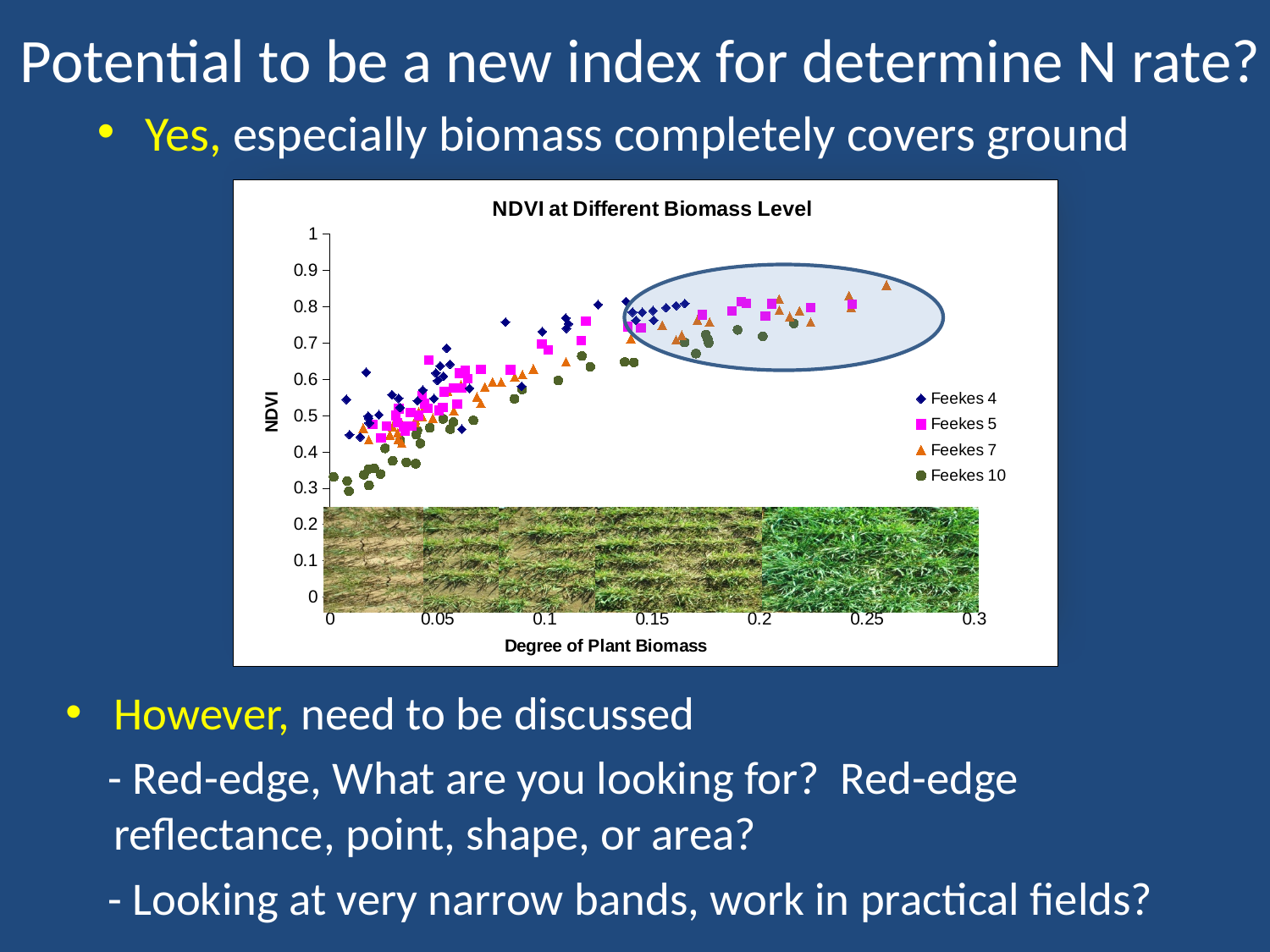
What is the label of the horizontal axis? Degree of Plant Biomass What is the label of the vertical axis? NDVI What kind of chart is shown on the slide? Scatter chart Which series reaches the highest NDVI value on the chart? Feekes 7 Does NDVI generally rise or fall as Degree of Plant Biomass increases? Rise Are the NDVI values of the Feekes 10 points at the lowest biomass levels (near 0) greater or less than 0.4? less What is the title of the chart? NDVI at Different Biomass Level Which series are listed in the chart's legend? Feekes 4, Feekes 5, Feekes 7, Feekes 10 What is the maximum value shown on the vertical (NDVI) axis? 1 Is the NDVI value of the highest Feekes 7 point (at about 0.26 biomass) greater or less than 0.8? greater How many series does the chart's legend list? 4 What is the maximum value shown on the horizontal (Degree of Plant Biomass) axis? 0.3